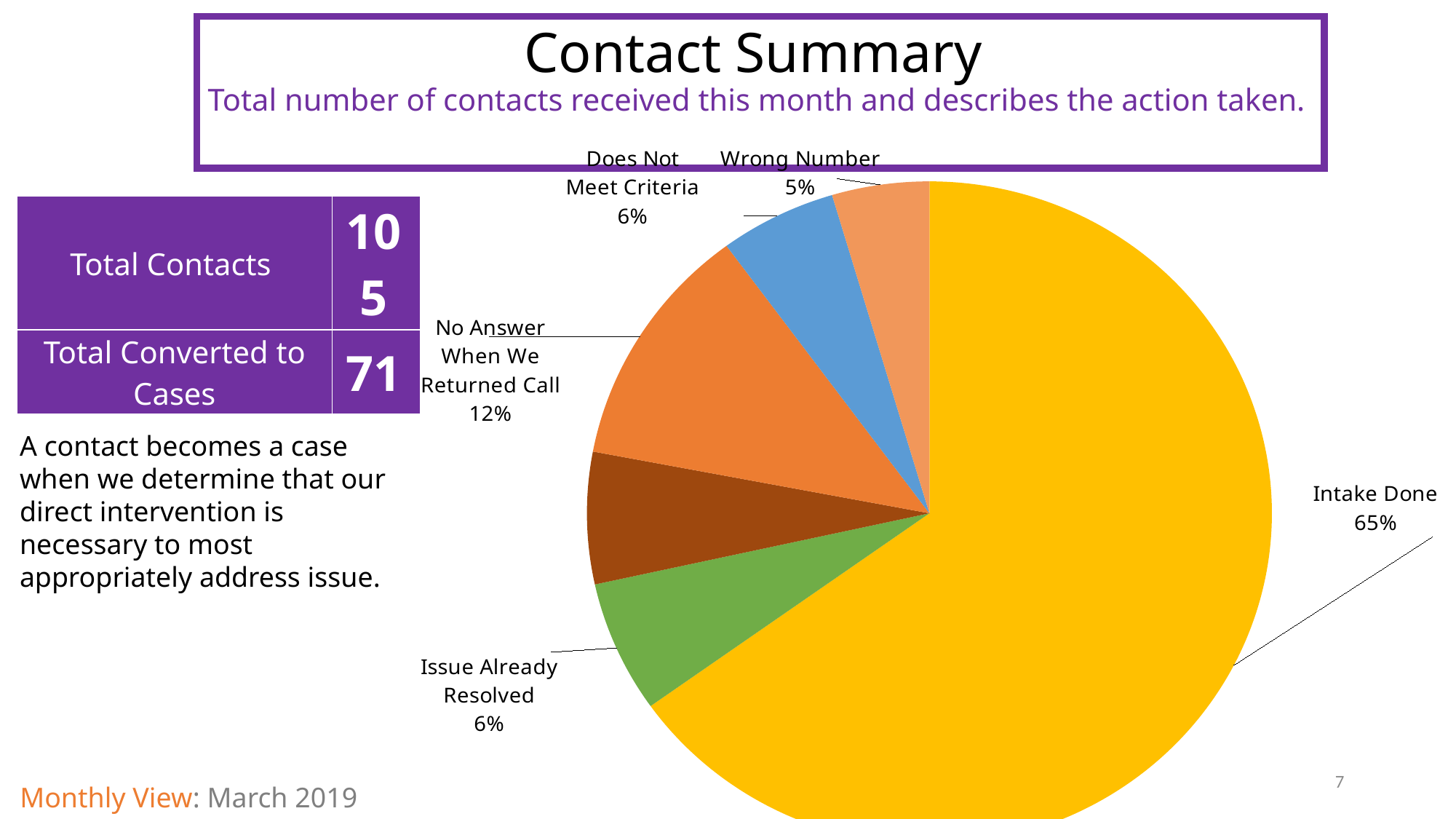
What percentage is shown for Does Not Meet Criteria? 6% How many percentage points larger is Intake Done than No Answer When We Returned Call? 53 percentage points What share of the pie is labeled No Answer When We Returned Call? 12% What percentage is shown for the Wrong Number slice? 5% What percentage of contacts had the Issue Already Resolved? 6% Which is larger: No Answer When We Returned Call or Does Not Meet Criteria? No Answer When We Returned Call What percentage of contacts does the Intake Done slice represent? 65% Which slice of the pie chart is the largest? Intake Done What type of chart is shown on the slide? Pie chart What is the difference in percentage points between Does Not Meet Criteria and Wrong Number? 1 percentage point Which labeled slice of the pie chart has the smallest percentage? Wrong Number What colour is the Intake Done slice of the pie chart? Yellow